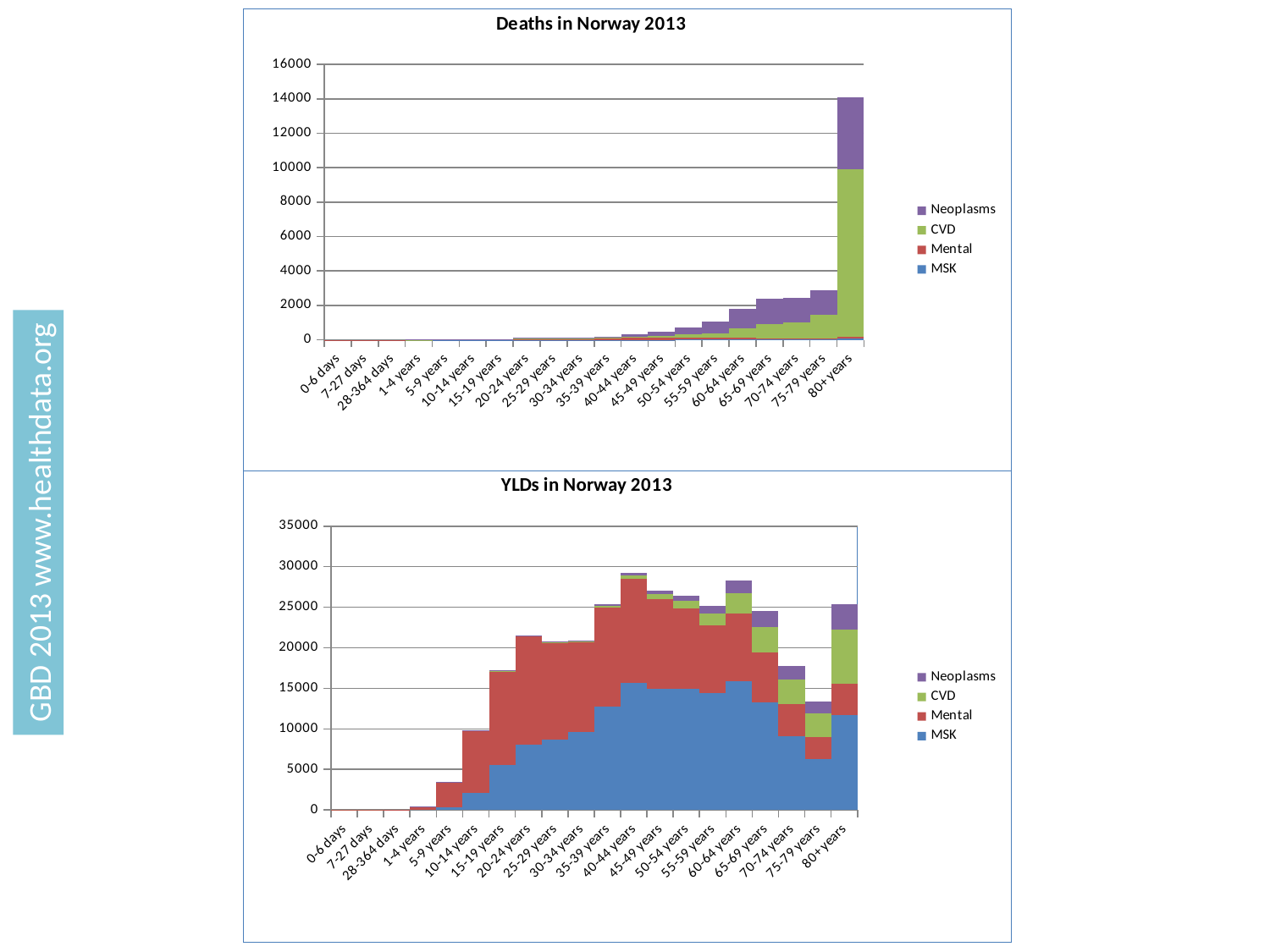
In the 'Deaths in Norway 2013' chart, is the total for 75-79 years greater or less than 4000? less In the 'Deaths in Norway 2013' chart, which age group has the highest total deaths? 80+ years In the 'YLDs in Norway 2013' chart, which age group has the highest total YLDs? 40-44 years In the 'Deaths in Norway 2013' chart, is the total for 80+ years greater or less than 12000? greater What type of chart is the 'Deaths in Norway 2013' chart? stacked bar chart How many series does the legend of the 'YLDs in Norway 2013' chart list? 4 How many age categories are shown on the x axis of the 'Deaths in Norway 2013' chart? 20 In the 'Deaths in Norway 2013' chart, which series makes up the largest part of the 80+ years bar? CVD In the 'YLDs in Norway 2013' chart, is the total for 40-44 years greater or less than 25000? greater In the 'YLDs in Norway 2013' chart, which has the larger total: 40-44 years or 75-79 years? 40-44 years In the 'Deaths in Norway 2013' chart, do total deaths generally rise or fall as age increases along the x axis? rise